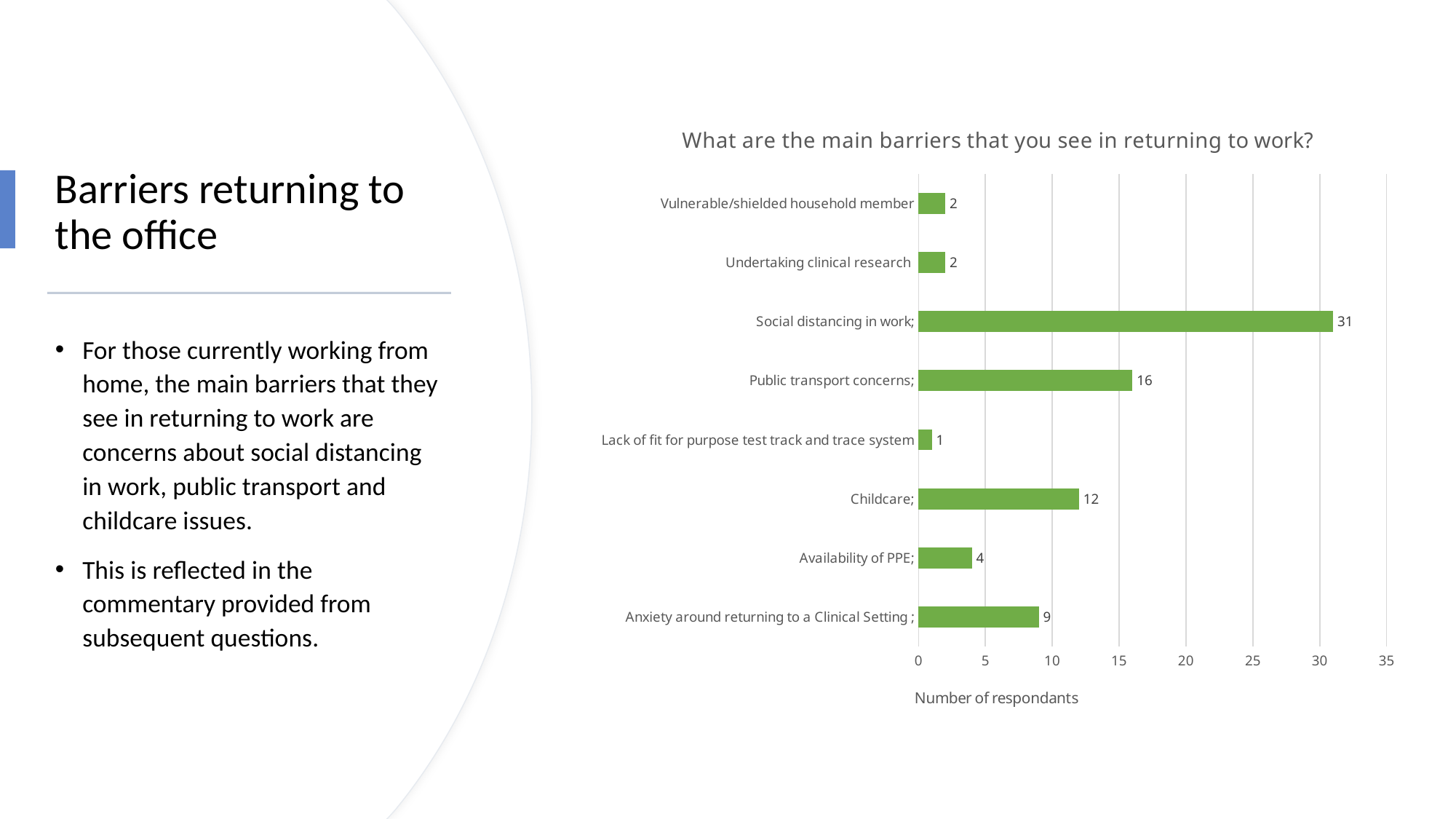
Which barrier has the highest number of respondents? Social distancing in work What is the value for Availability of PPE? 4 What is the label of the horizontal axis? Number of respondants What is the title of the chart? What are the main barriers that you see in returning to work? What is the difference between the number of respondents for Social distancing in work and Public transport concerns? 15 How many barrier categories are shown in the chart? 8 How many respondents cited social distancing in work as a barrier? 31 Which has more respondents: Childcare or Anxiety around returning to a Clinical Setting? Childcare How many respondents cited Childcare as a barrier? 12 What type of chart is shown on the slide? Bar chart What is the value for Public transport concerns? 16 Which barrier has the lowest number of respondents? Lack of fit for purpose test track and trace system